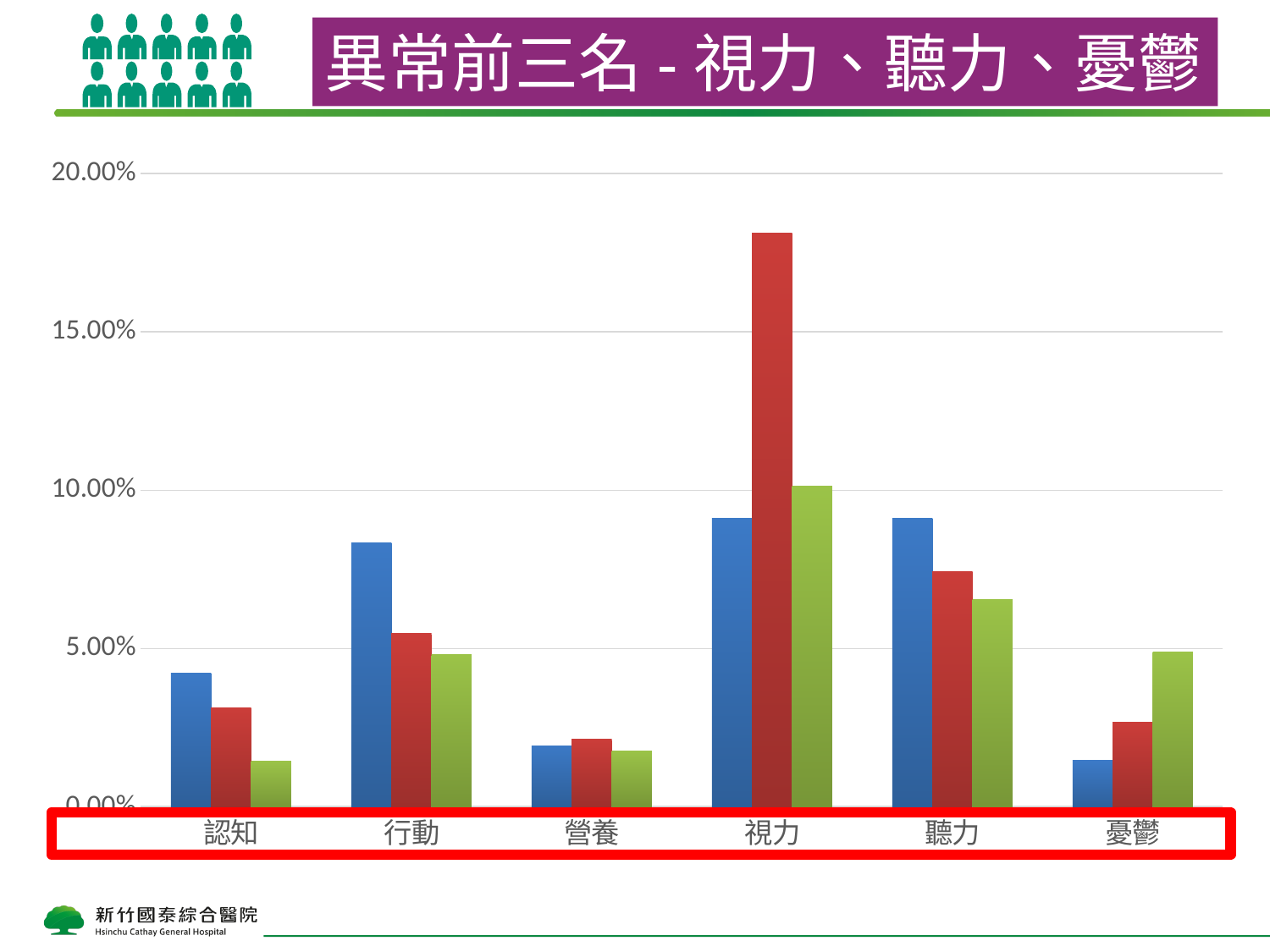
Which category has the tallest bar in the chart? 視力 What is the title of the slide containing the chart? 異常前三名 - 視力、聽力、憂鬱 For 憂鬱, which bar is taller, the blue bar or the green bar? green bar Is the value of the blue bar for 行動 greater or less than 5.00%? greater Which category has the tallest green bar? 視力 Is the value of the red bar for 視力 greater or less than 15.00%? greater Which category has the tallest red bar? 視力 What kind of chart is shown on the slide? bar chart Is the value of the green bar for 認知 greater or less than 5.00%? less How many bars are plotted for each category in the chart? 3 How many categories are shown on the x axis of the chart? 6